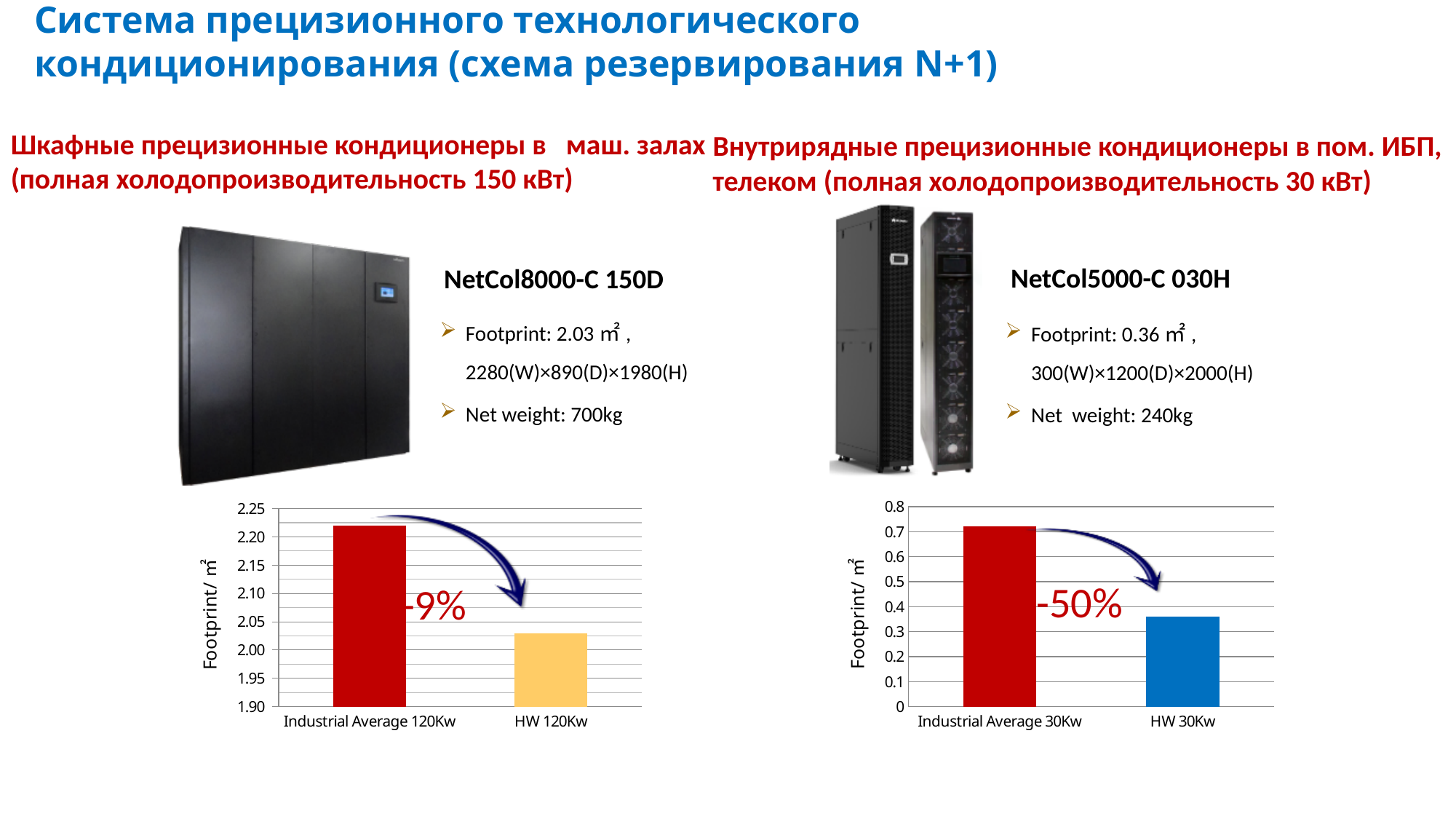
In the left chart (Footprint for 120Kw), which category has the lower footprint? HW 120Kw In the right chart (Footprint for 30Kw), is the value for HW 30Kw greater or less than 0.4? less In the right chart (Footprint for 30Kw), do the values rise or fall from left to right? fall In the right chart (Footprint for 30Kw), which category has the higher footprint? Industrial Average 30Kw In the left chart (Footprint for 120Kw), what percentage change is written between the two bars? -9% In the left chart (Footprint for 120Kw), is the value for HW 120Kw greater or less than 2.05? less In the left chart (Footprint for 120Kw), how many bars are plotted? 2 In the left chart (Footprint for 120Kw), which category has the higher footprint? Industrial Average 120Kw In the left chart (Footprint for 120Kw), what kind of chart is shown? bar chart In the right chart (Footprint for 30Kw), what is the label on the vertical axis? Footprint/ m²